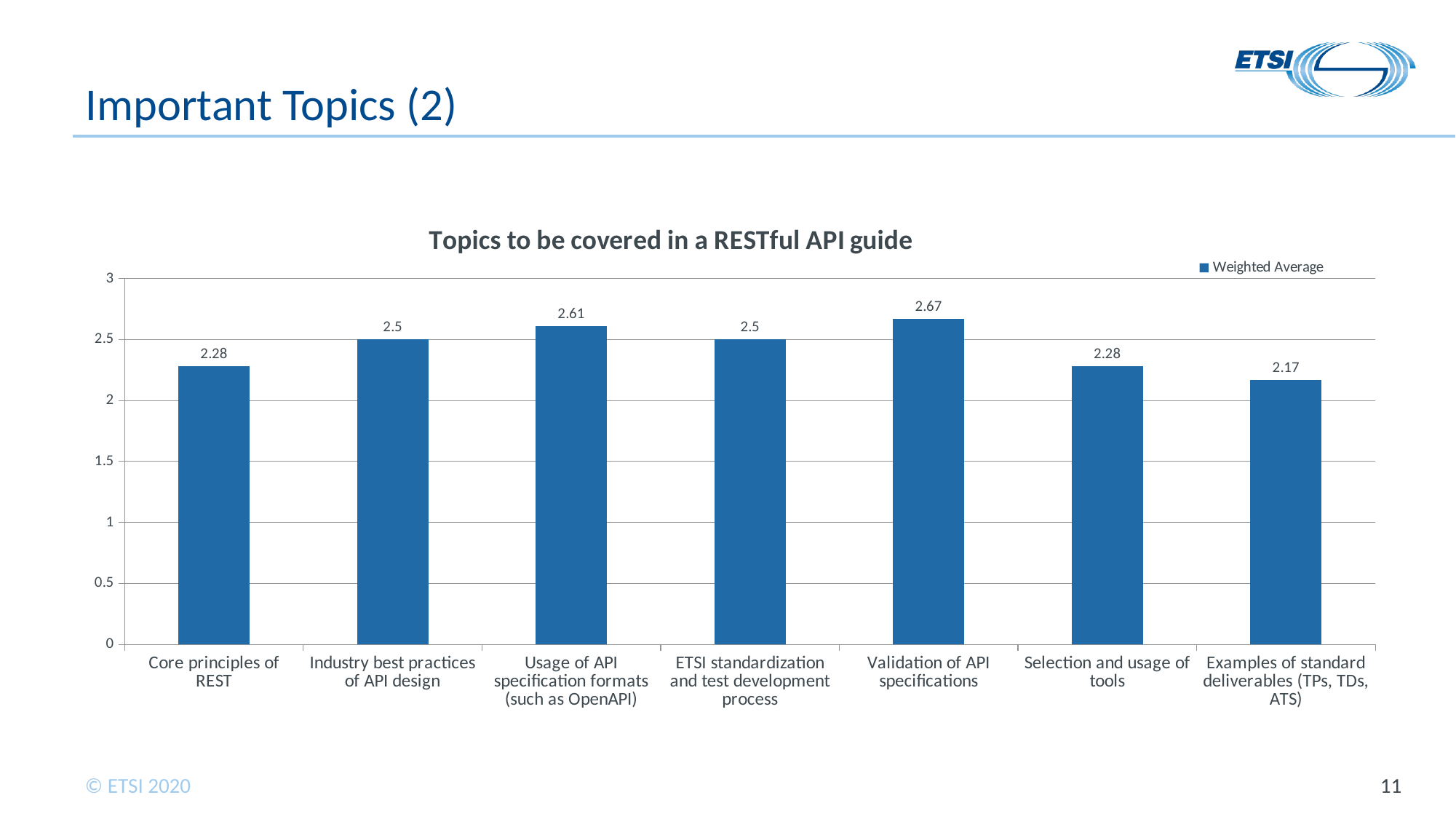
How many topics are shown on the chart? 7 Which topic has the highest weighted average? Validation of API specifications What is the weighted average for Usage of API specification formats (such as OpenAPI)? 2.61 Is the weighted average for ETSI standardization and test development process greater or less than 2? greater Which topic has the lowest weighted average? Examples of standard deliverables (TPs, TDs, ATS) What is the weighted average for Core principles of REST? 2.28 What kind of chart is shown on the slide? Bar chart What is the title of the chart? Topics to be covered in a RESTful API guide How many series does the legend list? 1 What is the difference between the weighted averages for Validation of API specifications and Examples of standard deliverables (TPs, TDs, ATS)? 0.5 What is the weighted average for Validation of API specifications? 2.67 Which has a higher weighted average: Industry best practices of API design or Selection and usage of tools? Industry best practices of API design